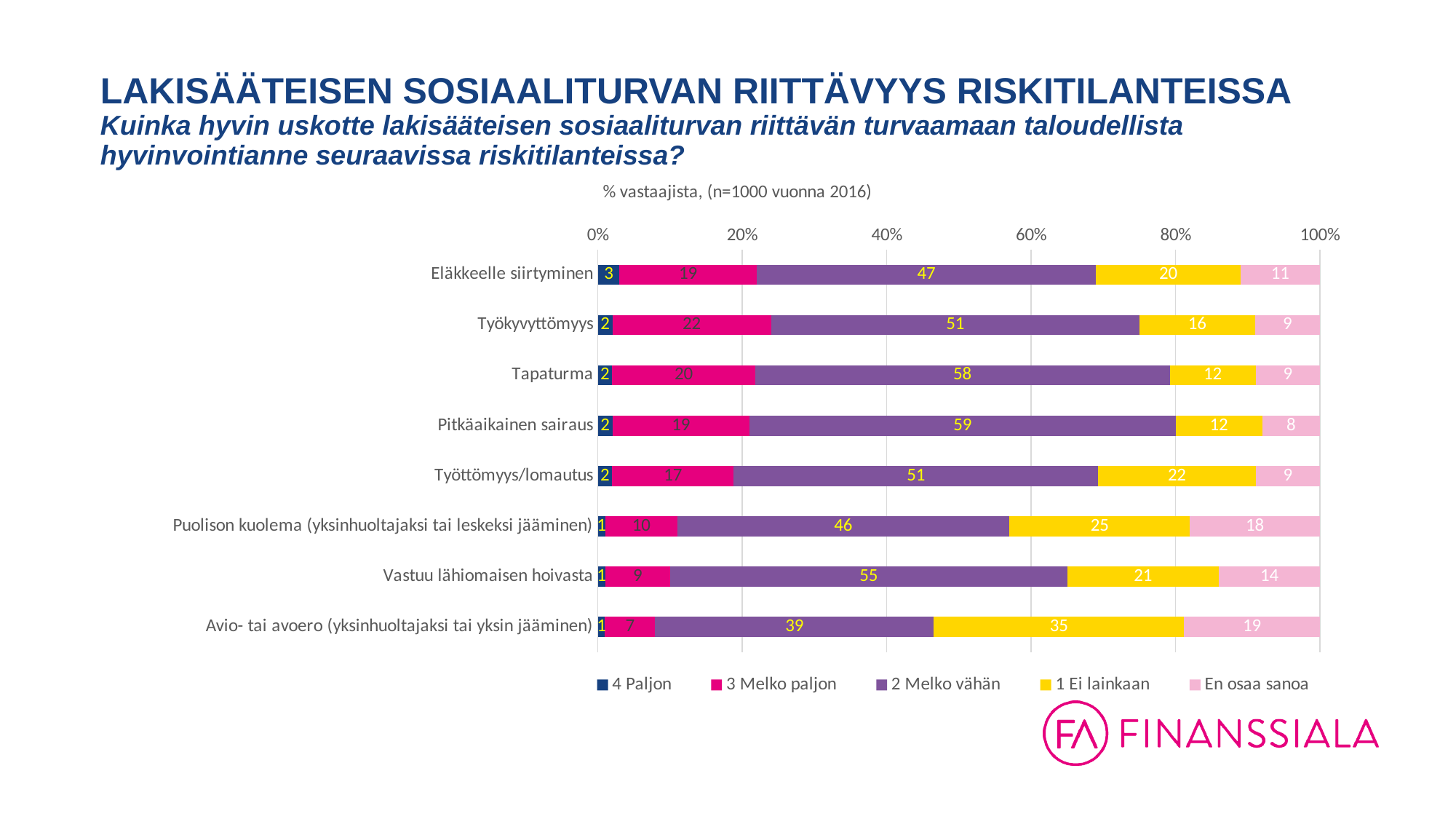
Which category has the highest value for "2 Melko vähän"? Pitkäaikainen sairaus What is the difference between the "1 Ei lainkaan" values for Avio- tai avoero and Tapaturma? 23 What is the value of "2 Melko vähän" for Tapaturma? 58 What is the sample size stated in the chart subtitle? n=1000 vuonna 2016 What is the value of "1 Ei lainkaan" for Avio- tai avoero (yksinhuoltajaksi tai yksin jääminen)? 35 How many series does the legend list? 5 How many categories (risk situations) are shown in the chart? 8 Which is larger: the "3 Melko paljon" value for Työkyvyttömyys or for Eläkkeelle siirtyminen? Työkyvyttömyys Which category has the lowest value for "3 Melko paljon"? Avio- tai avoero (yksinhuoltajaksi tai yksin jääminen) What is the total of the stacked bar for Eläkkeelle siirtyminen? 100 What kind of chart is shown on the slide? Stacked bar chart What is the value of "En osaa sanoa" for Puolison kuolema (yksinhuoltajaksi tai leskeksi jääminen)? 18